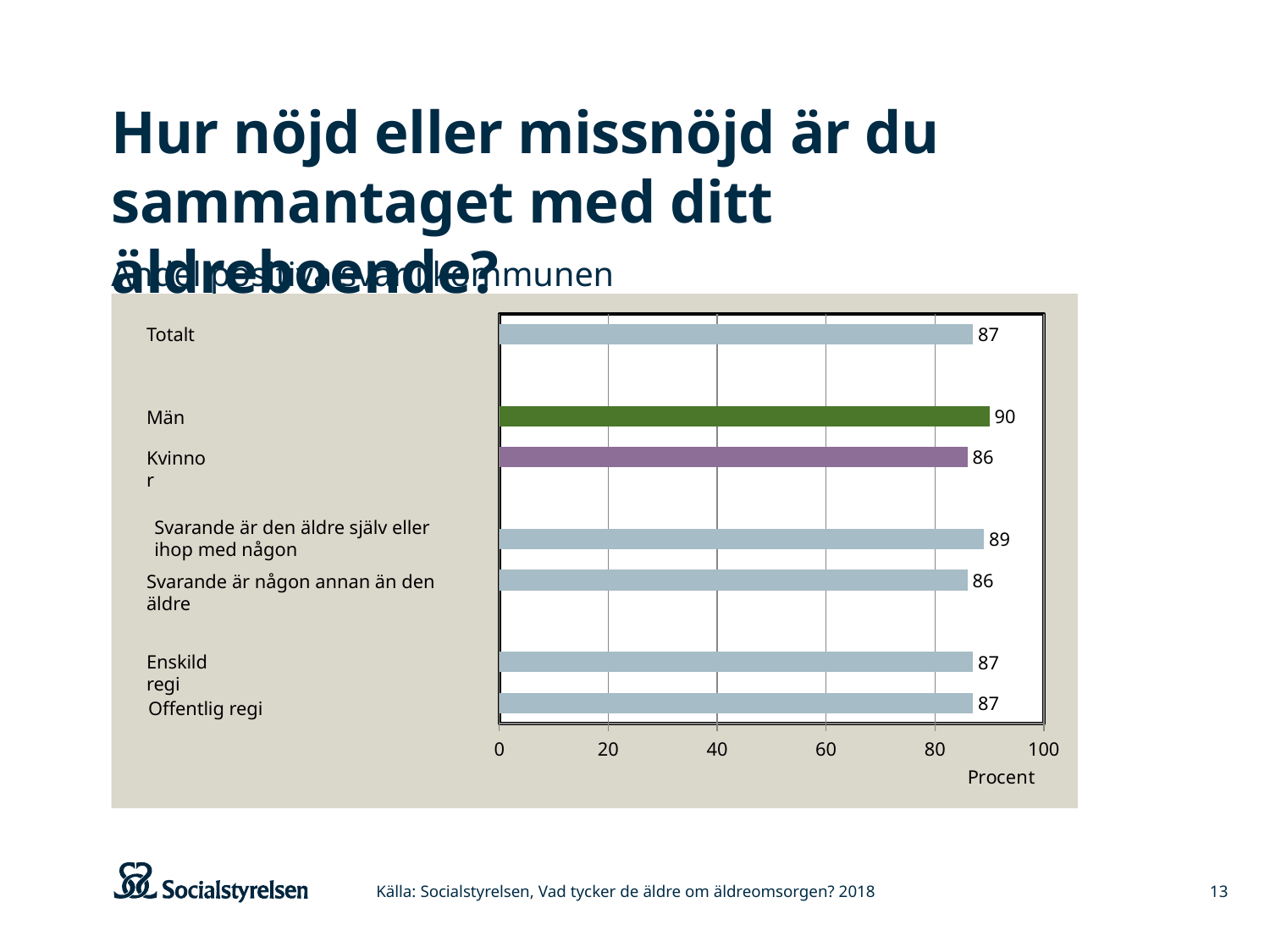
What is the label on the horizontal axis of the chart? Procent What is the value for 'Svarande är den äldre själv eller ihop med någon'? 89 What is the value for Kvinnor? 86 What is the value for Totalt? 87 What kind of chart is shown on the slide? Bar chart Which category has the highest value? Män What is the difference between 'Svarande är den äldre själv eller ihop med någon' and 'Svarande är någon annan än den äldre'? 3 What is the value for Män? 90 Which is larger, the value for Män or the value for Totalt? Män How many bars are plotted in the chart? 7 What is the difference between the values for Män and Kvinnor? 4 What is the value for Offentlig regi? 87